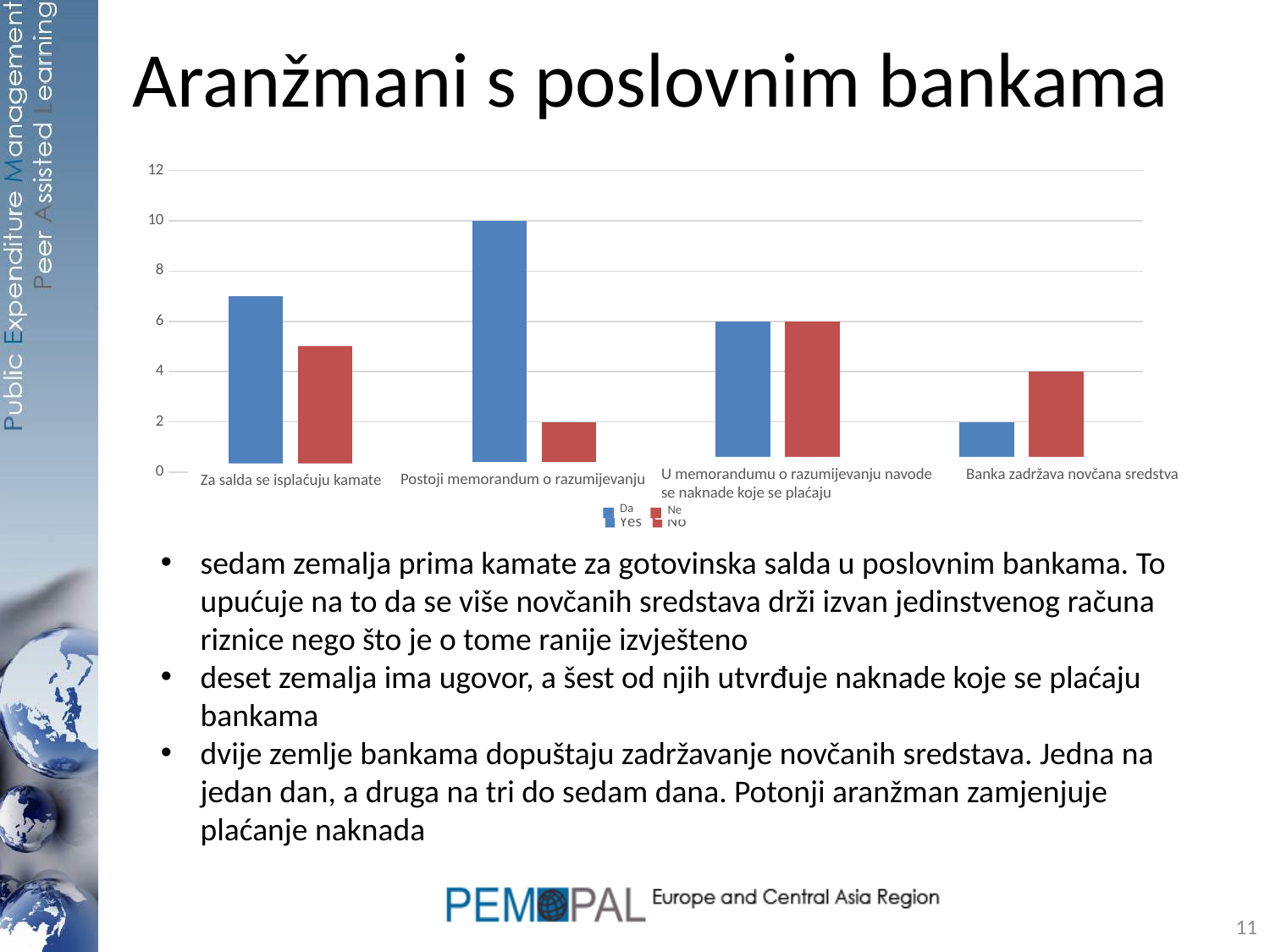
What is the value of the 'Da' (Yes) bar for 'Banka zadržava novčana sredstva'? 2 What is the value of the 'Da' (Yes) bar for 'U memorandumu o razumijevanju navode se naknade koje se plaćaju'? 6 What is the value of the 'Ne' (No) bar for 'Banka zadržava novčana sredstva'? 4 Which category has the highest 'Da' (Yes) bar? Postoji memorandum o razumijevanju What is the value of the 'Ne' (No) bar for 'Postoji memorandum o razumijevanju'? 2 What is the difference between the 'Da' (Yes) and 'Ne' (No) bars for 'Postoji memorandum o razumijevanju'? 8 What is the value of the 'Da' (Yes) bar for 'Postoji memorandum o razumijevanju'? 10 How many series does the chart's legend list? 2 What kind of chart is shown on the slide? bar chart Which is larger for 'Banka zadržava novčana sredstva': the 'Da' (Yes) bar or the 'Ne' (No) bar? Ne (No) How many categories are shown on the x axis of the chart? 4 Is the 'Da' (Yes) value for 'Za salda se isplaćuju kamate' greater or less than 6? greater